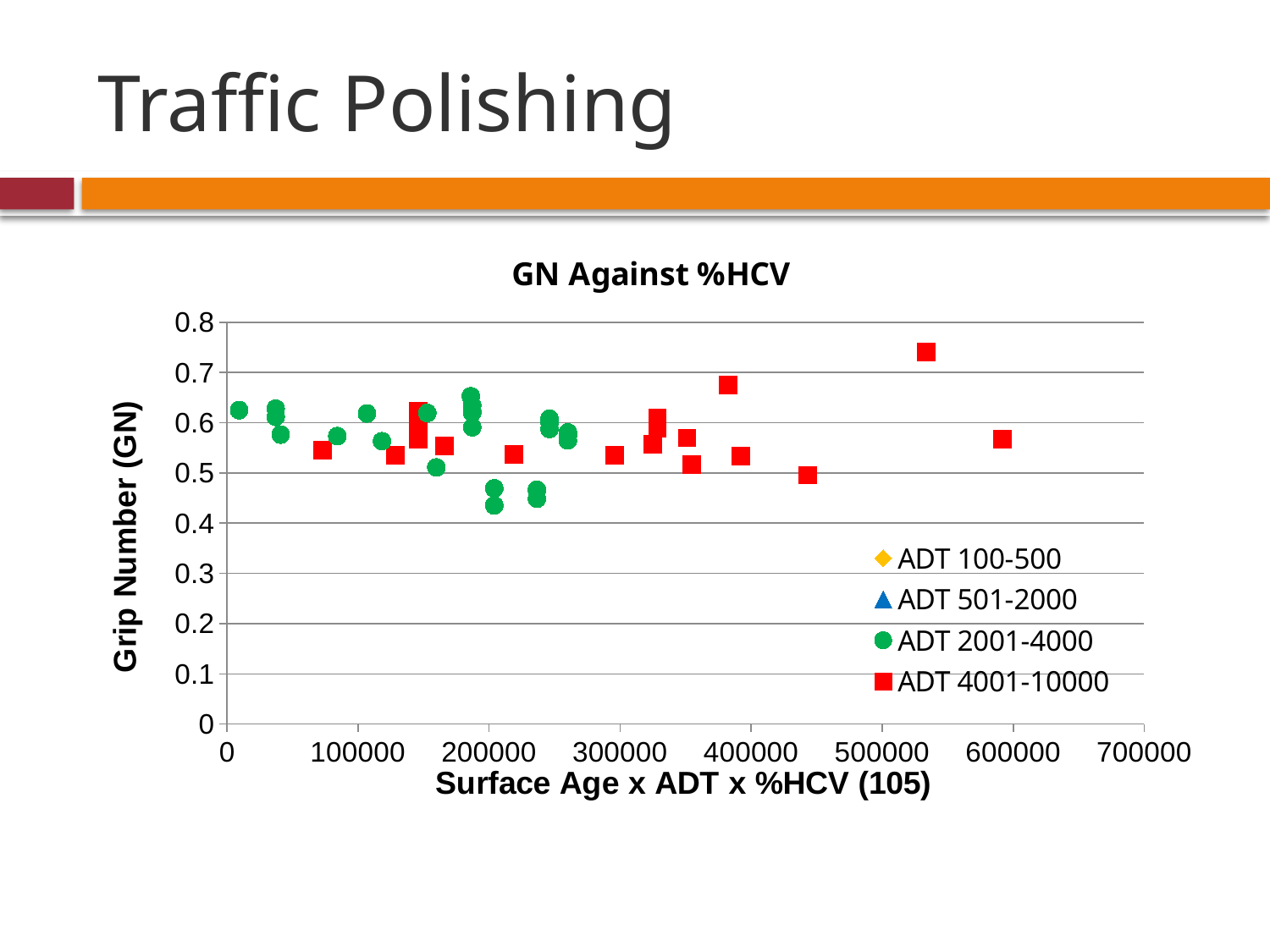
Is the highest Grip Number value for the ADT 4001-10000 series greater or less than 0.7? greater Which series contains the point with the lowest Grip Number? ADT 2001-4000 Is the lowest Grip Number value for the ADT 2001-4000 series greater or less than 0.5? less What kind of chart is shown on the slide? scatter chart Which series contains the point with the highest Grip Number? ADT 4001-10000 What is the title of the chart? GN Against %HCV How many of the legend's series have points visibly plotted on the chart? 2 Which series has the point with the largest x-axis value? ADT 4001-10000 Is the Grip Number of the ADT 4001-10000 point plotted near 600000 on the x axis greater or less than 0.6? less How many series does the legend list? 4 What is the label of the vertical axis? Grip Number (GN)